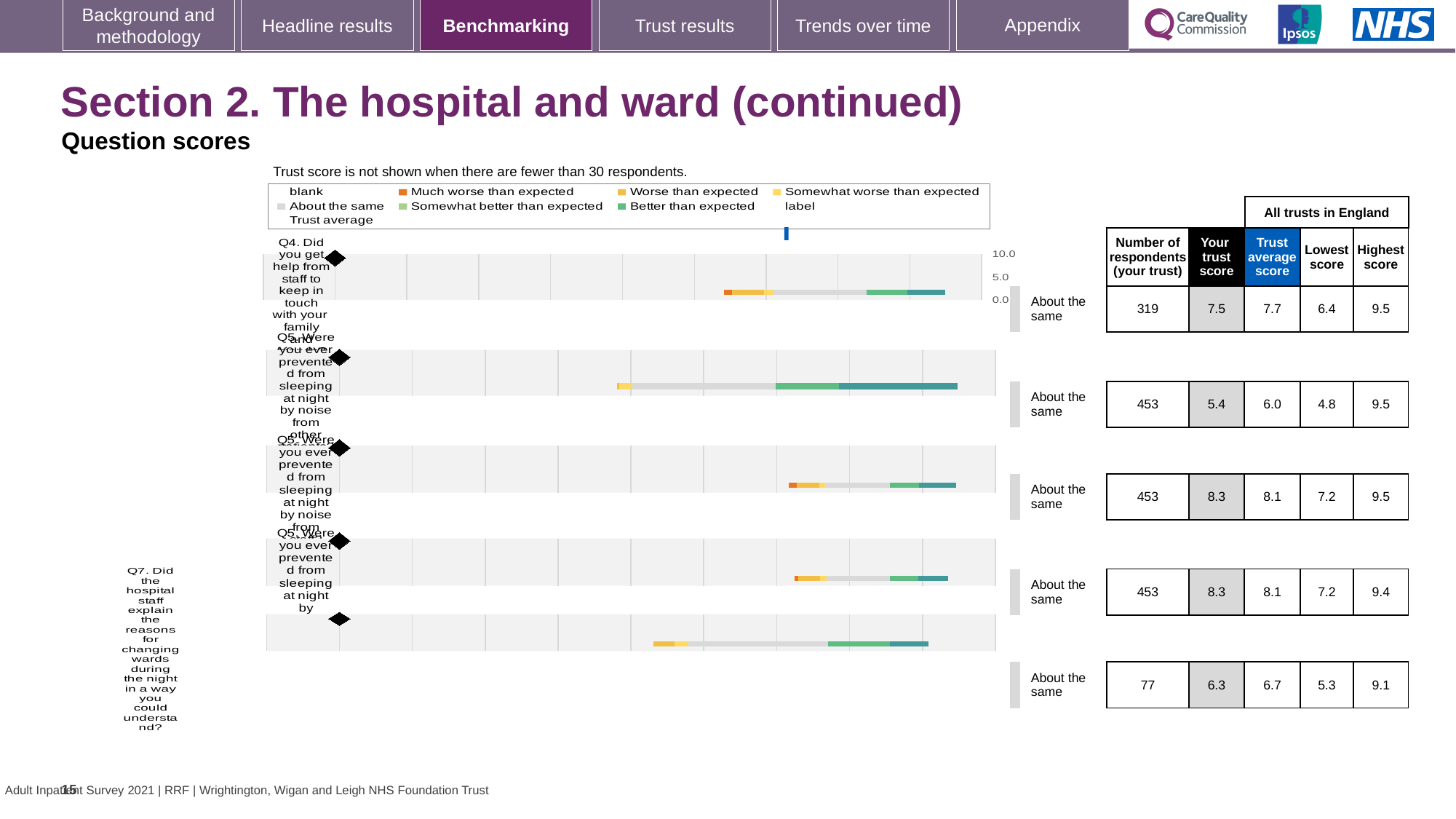
How many question rows are shown in the chart on this slide? 5 Which question has the fewest respondents from your trust? Q7 What benchmark label is shown next to the Q4 bar? About the same For Q7, which is larger: your trust score or the trust average score? Trust average score How many respondents from your trust answered Q4 (help from staff to keep in touch with family and friends)? 319 What is the lowest 'Your trust score' shown in the table? 5.4 What is the difference between the trust average score and your trust score for Q4? 0.2 What is the highest score across all trusts in England for Q7 (explaining reasons for changing wards during the night)? 9.1 What is your trust score for Q4 (help from staff to keep in touch with family and friends)? 7.5 What kind of chart is used to show the question scores on this slide? bar chart What is the lowest score across all trusts in England for Q7 (explaining reasons for changing wards during the night)? 5.3 What is the trust average score for Q7 (explaining reasons for changing wards during the night)? 6.7